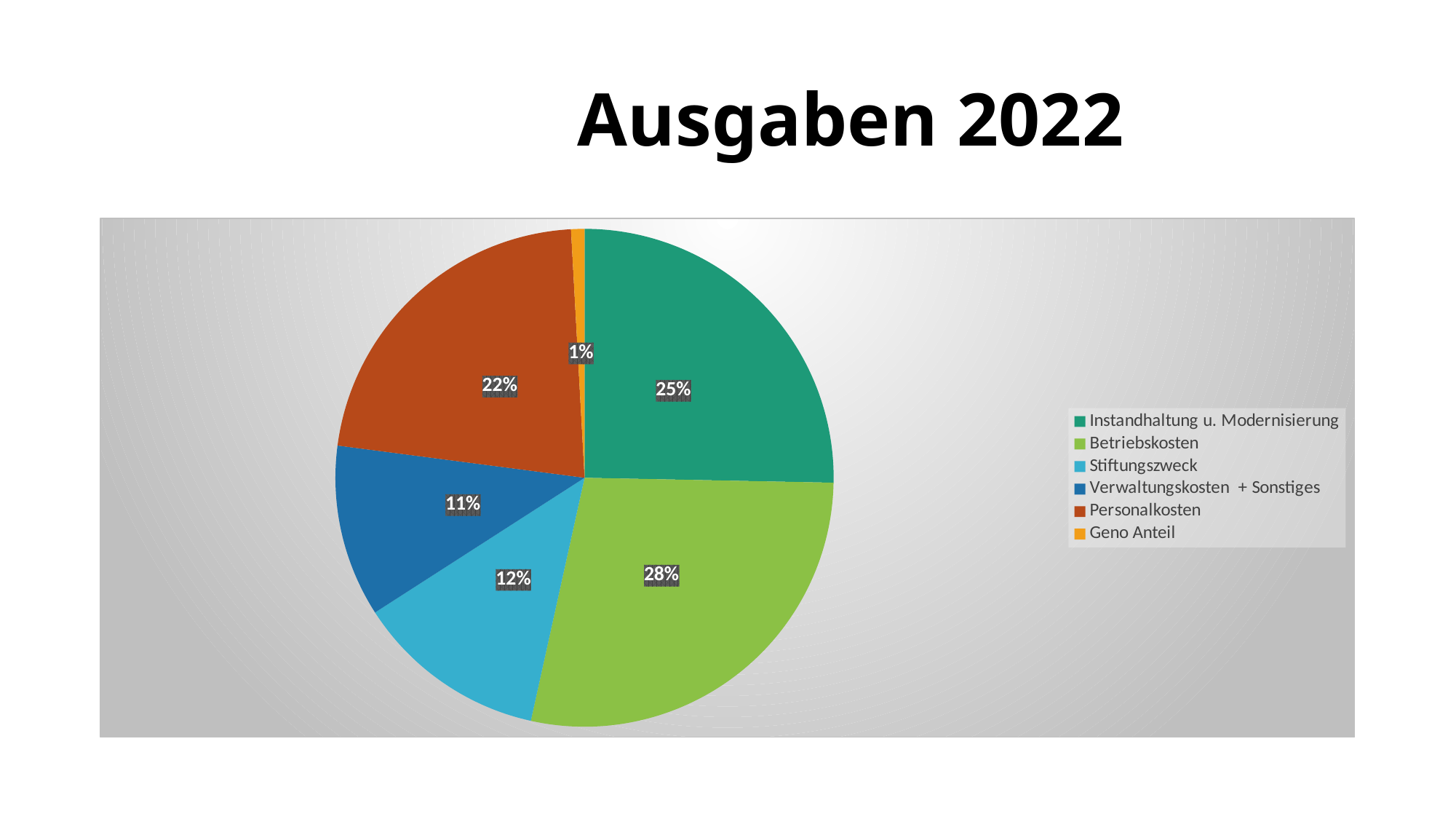
How many categories does the legend list? 6 What is the difference in percentage points between Betriebskosten and Personalkosten? 6 Which category has the largest share of the pie? Betriebskosten What is the title of the chart? Ausgaben 2022 Which category has the smallest share of the pie? Geno Anteil What share of the pie does Stiftungszweck have? 12% What share of the pie does Personalkosten have? 22% What share of the pie does Instandhaltung u. Modernisierung have? 25% What share of the pie does Geno Anteil have? 1% What share of the pie does Betriebskosten have? 28% What share of the pie does Verwaltungskosten + Sonstiges have? 11% What type of chart is shown on the slide? pie chart